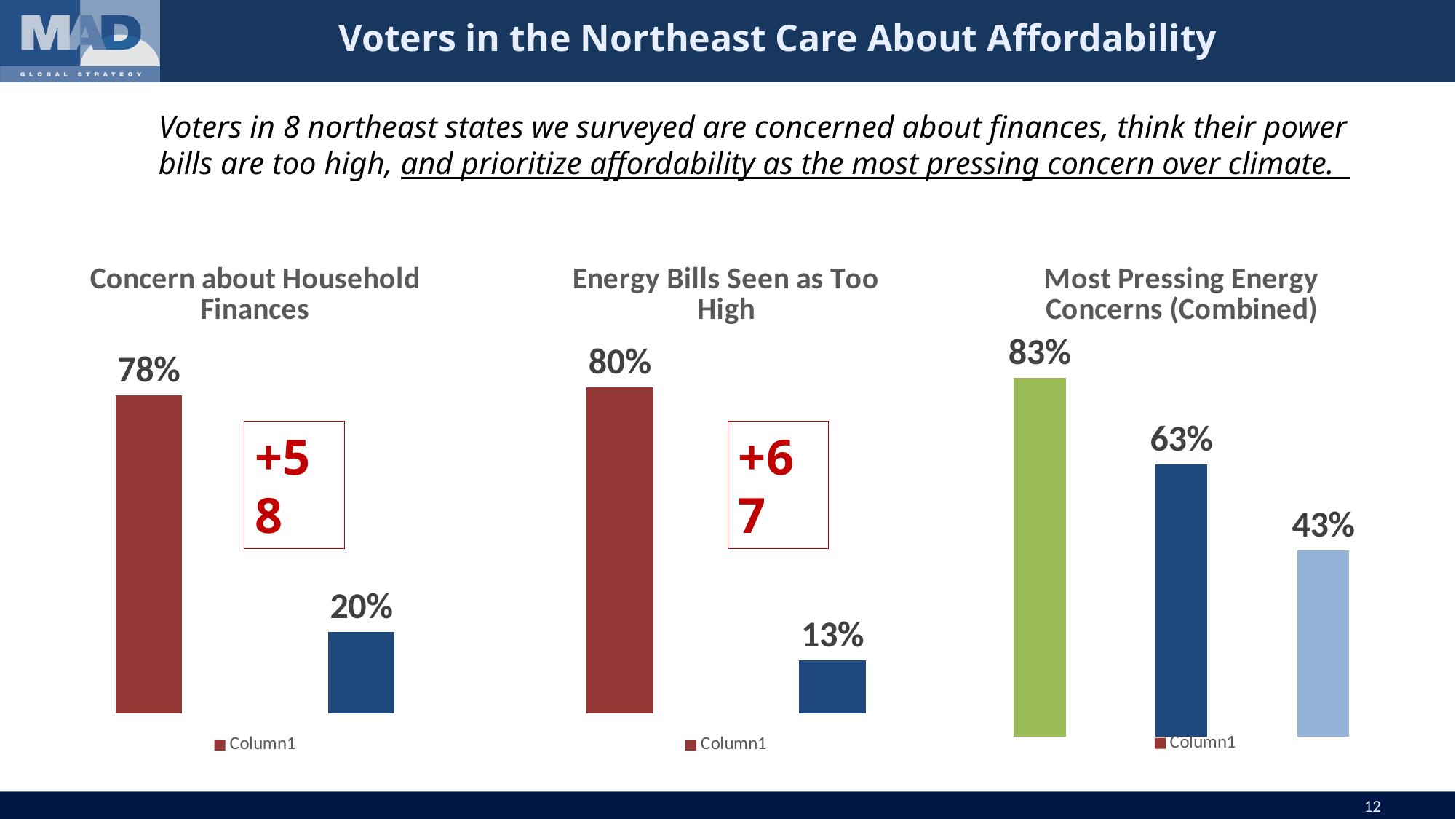
In the chart titled "Concern about Household Finances", what value is shown on the left (red) bar? 78% In the chart titled "Most Pressing Energy Concerns (Combined)", what value is shown on the light blue bar on the right? 43% In the chart titled "Energy Bills Seen as Too High", what value is shown on the left (red) bar? 80% In the chart titled "Concern about Household Finances", what value is shown on the right (blue) bar? 20% In the chart titled "Most Pressing Energy Concerns (Combined)", how many bars are plotted? 3 In the chart titled "Most Pressing Energy Concerns (Combined)", which bar has the lowest value? The light blue bar on the right (43%) What legend entry is shown beneath the chart titled "Concern about Household Finances"? Column1 What kind of chart is the chart titled "Energy Bills Seen as Too High"? Bar chart In the chart titled "Energy Bills Seen as Too High", what is the difference between the two bars? 67 In the chart titled "Concern about Household Finances", what is the difference between the two bars? 58 In the chart titled "Most Pressing Energy Concerns (Combined)", what value is shown on the green bar? 83% In the chart titled "Energy Bills Seen as Too High", what value is shown on the right (blue) bar? 13%